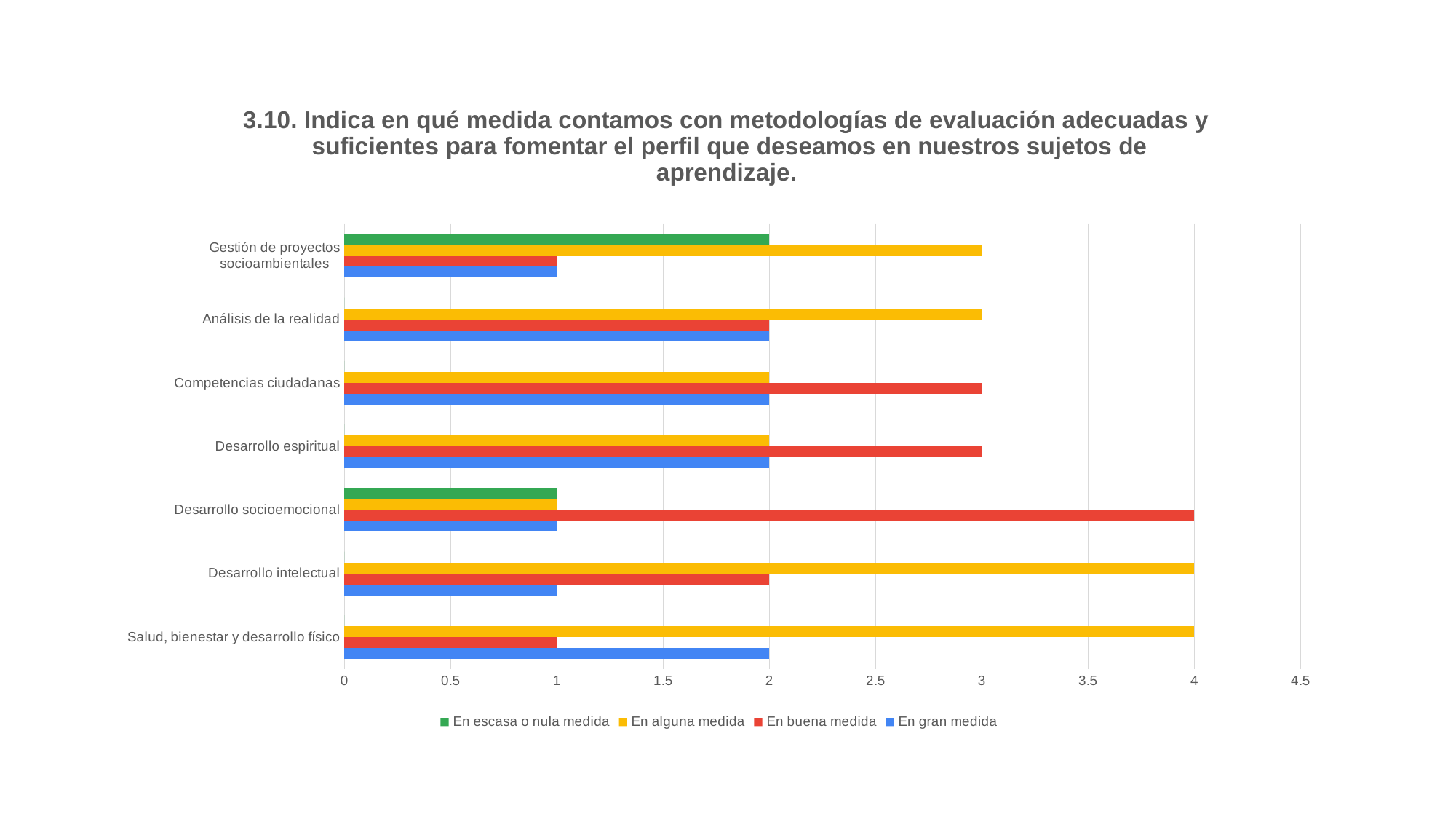
Which category has the highest value for 'En buena medida'? Desarrollo socioemocional What is the value of 'En buena medida' for Desarrollo socioemocional? 4 Is the value of 'En alguna medida' for Gestión de proyectos socioambientales greater or less than 2.5? greater What is the value of 'En gran medida' for Salud, bienestar y desarrollo físico? 2 What is the value of 'En escasa o nula medida' for Gestión de proyectos socioambientales? 2 What is the difference between 'En alguna medida' and 'En gran medida' for Desarrollo intelectual? 3 What is the value of 'En alguna medida' for Desarrollo intelectual? 4 For Competencias ciudadanas, which is larger: 'En buena medida' or 'En alguna medida'? En buena medida Which colour represents 'En gran medida' in the legend? Blue How many categories are shown on the vertical axis? 7 What kind of chart is shown on the slide? Bar chart How many series does the legend list? 4